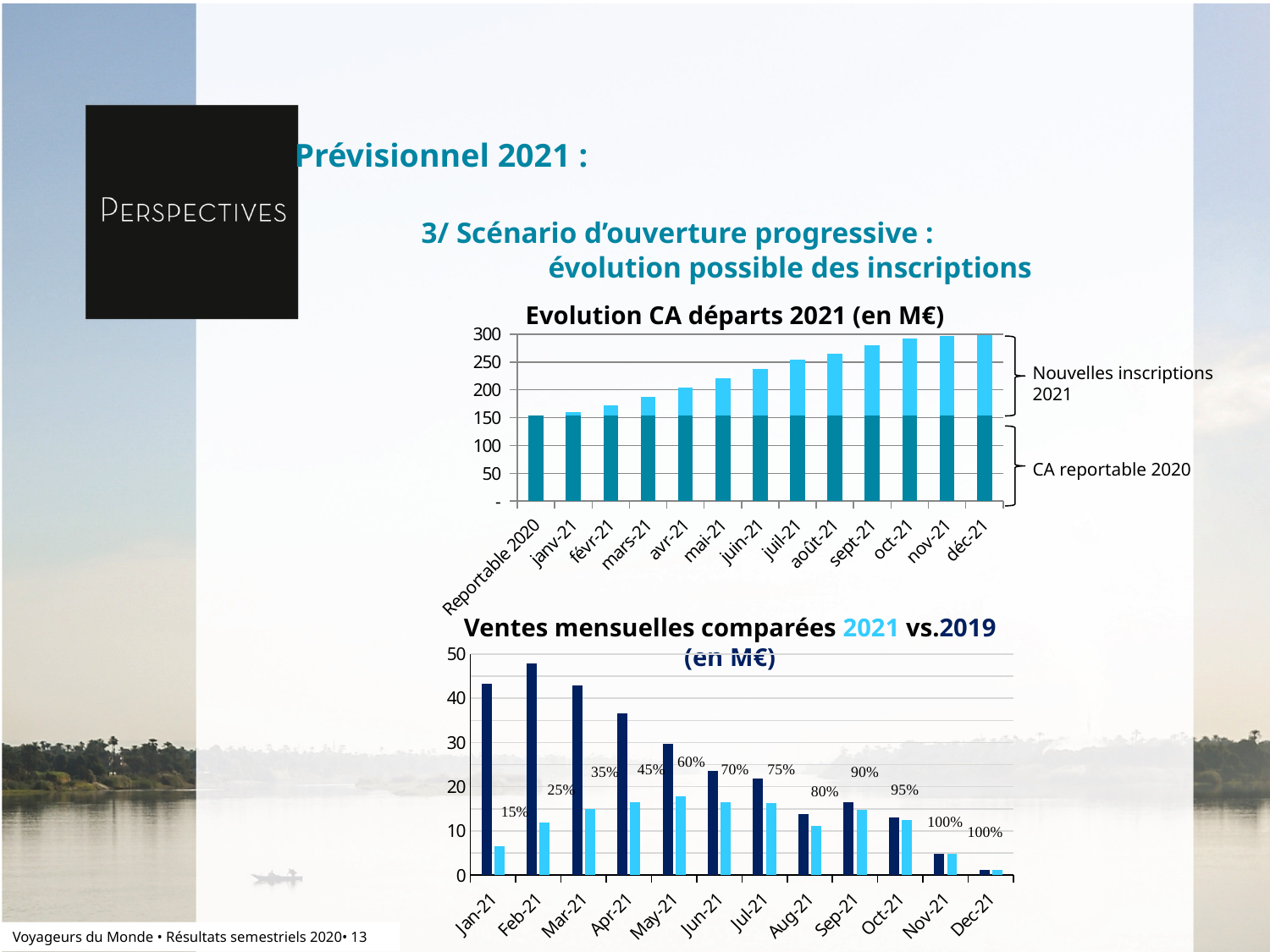
In the 'Ventes mensuelles comparées 2021 vs.2019 (en M€)' chart, which month has the highest dark (2019) bar? Feb-21 In the 'Ventes mensuelles comparées 2021 vs.2019 (en M€)' chart, what percentage label is shown for Jun-21? 70% In the 'Evolution CA départs 2021 (en M€)' chart, is the total for déc-21 greater or less than 250? greater What kind of chart is the 'Evolution CA départs 2021 (en M€)' chart? bar chart In the 'Evolution CA départs 2021 (en M€)' chart, which category has the highest total bar? déc-21 In the 'Ventes mensuelles comparées 2021 vs.2019 (en M€)' chart, what percentage label is shown for Jan-21? 15% In the 'Ventes mensuelles comparées 2021 vs.2019 (en M€)' chart, is the dark (2019) bar for Feb-21 greater or less than 40? greater How many months are shown on the x axis of the 'Ventes mensuelles comparées 2021 vs.2019 (en M€)' chart? 12 In the 'Evolution CA départs 2021 (en M€)' chart, is the total for janv-21 greater or less than 200? less In the 'Evolution CA départs 2021 (en M€)' chart, what is the label of the lower (dark) segment of the bars? CA reportable 2020 In the 'Evolution CA départs 2021 (en M€)' chart, do the bar totals rise or fall from left to right? rise How many categories are shown on the x axis of the 'Evolution CA départs 2021 (en M€)' chart? 13